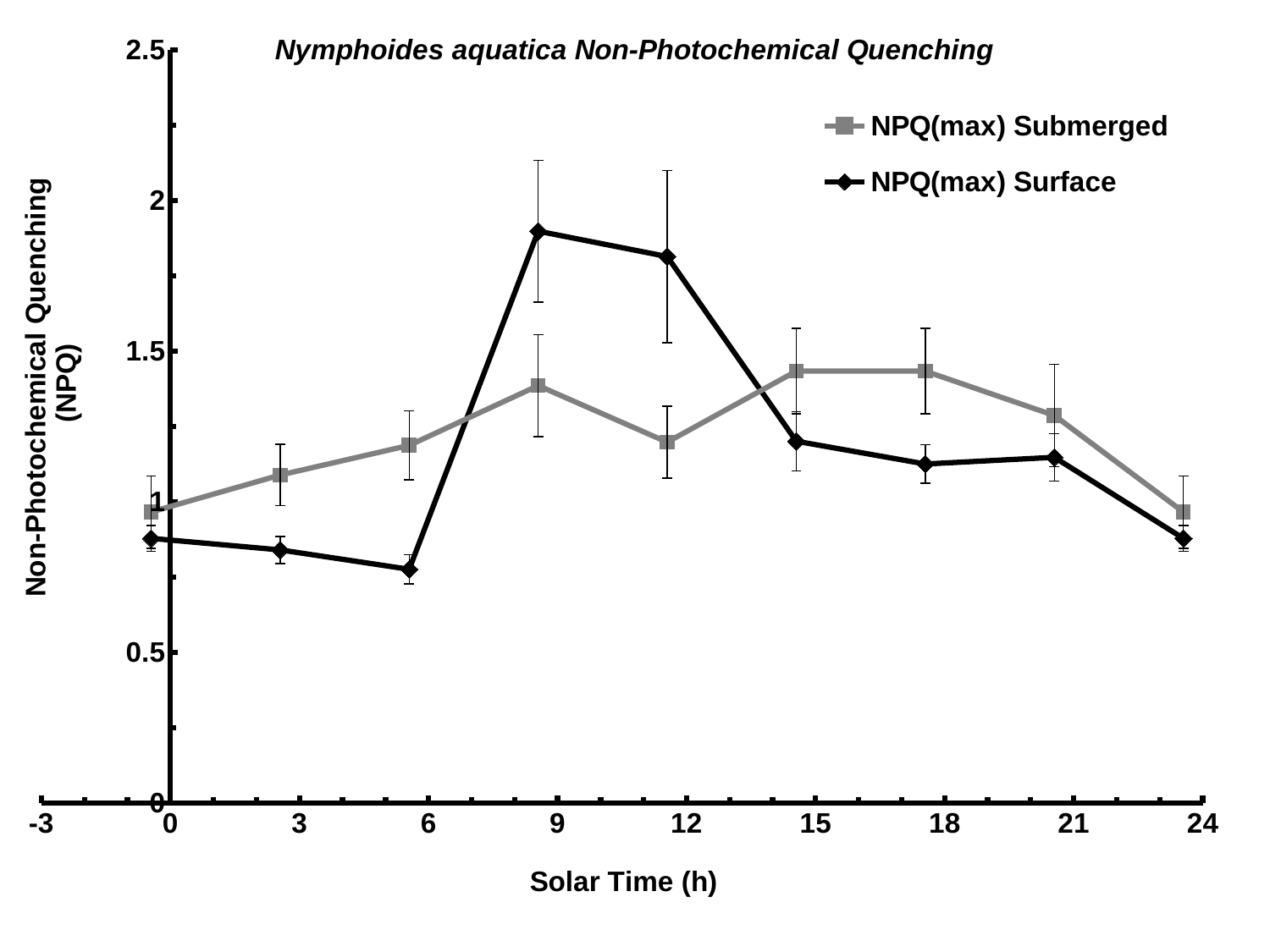
How many data points are plotted for the NPQ(max) Surface series? 9 Is the NPQ(max) Surface value at around 6 h greater or less than 1? less At around 18 h, which series has the higher value, NPQ(max) Submerged or NPQ(max) Surface? NPQ(max) Submerged Is the peak value of the NPQ(max) Surface series greater or less than 1.5? greater What kind of chart is shown on the slide? line chart How many series does the legend list? 2 What is the label of the x axis? Solar Time (h) Which series reaches the highest value on the chart? NPQ(max) Surface What is the title of the chart? Nymphoides aquatica Non-Photochemical Quenching Between 0 h and 6 h, does the NPQ(max) Surface series rise or fall? fall At around 9 h, which series has the higher value, NPQ(max) Submerged or NPQ(max) Surface? NPQ(max) Surface Which series contains the lowest value on the chart? NPQ(max) Surface